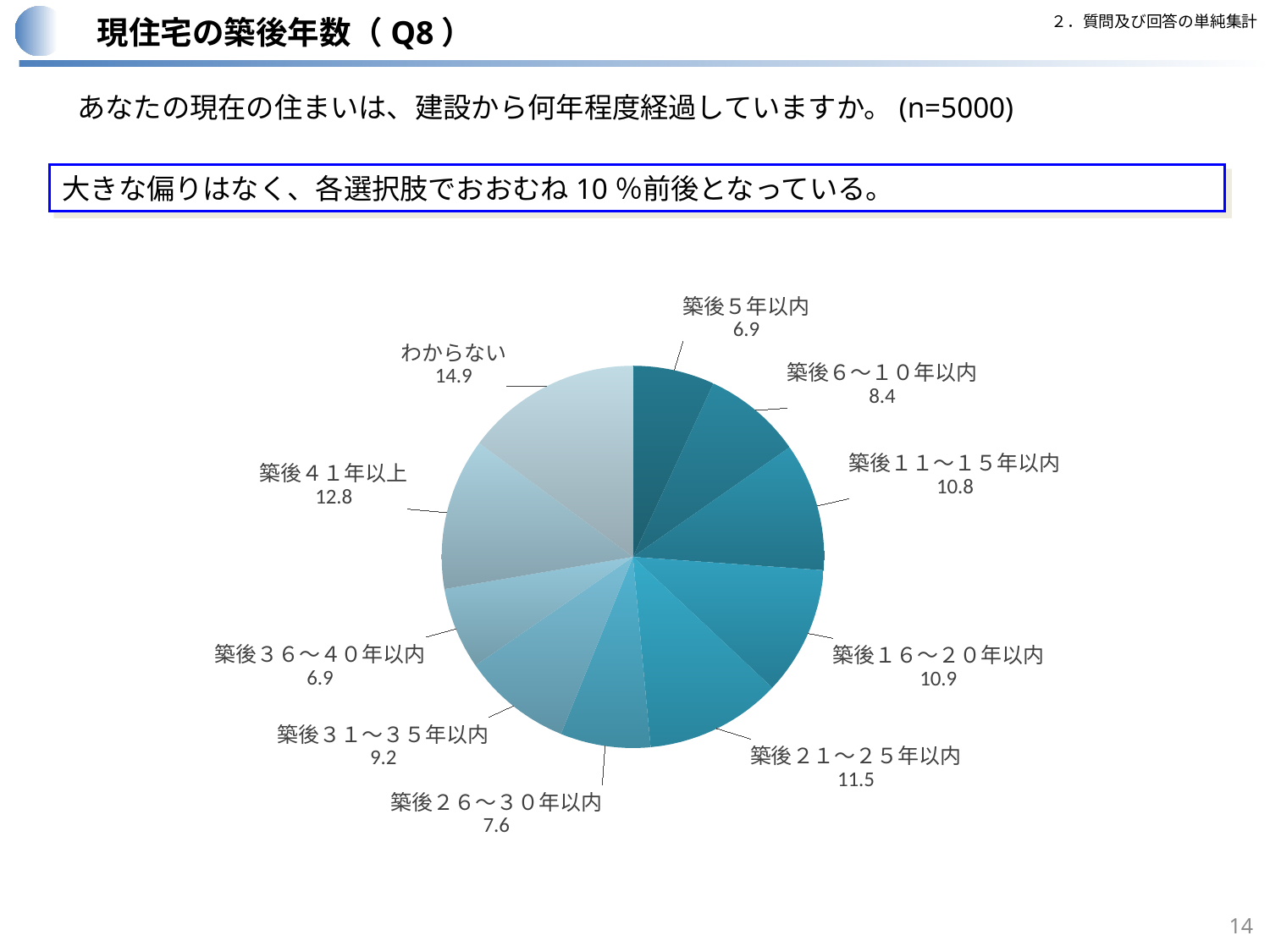
What is the sample size (n) stated on the slide? 5000 What is the value for 築後４１年以上? 12.8 What is the difference between the values for 築後４１年以上 and 築後３１～３５年以内? 3.6 What type of chart is shown on the slide? pie chart How many categories does the pie chart have? 10 Which category has the largest slice? わからない What is the value for 築後６～１０年以内? 8.4 What is the difference between the values for わからない and 築後５年以内? 8.0 Which is larger, the value for 築後２１～２５年以内 or the value for 築後１１～１５年以内? 築後２１～２５年以内 What is the value for 築後２６～３０年以内? 7.6 What is the value for 築後２１～２５年以内? 11.5 What is the value for わからない? 14.9